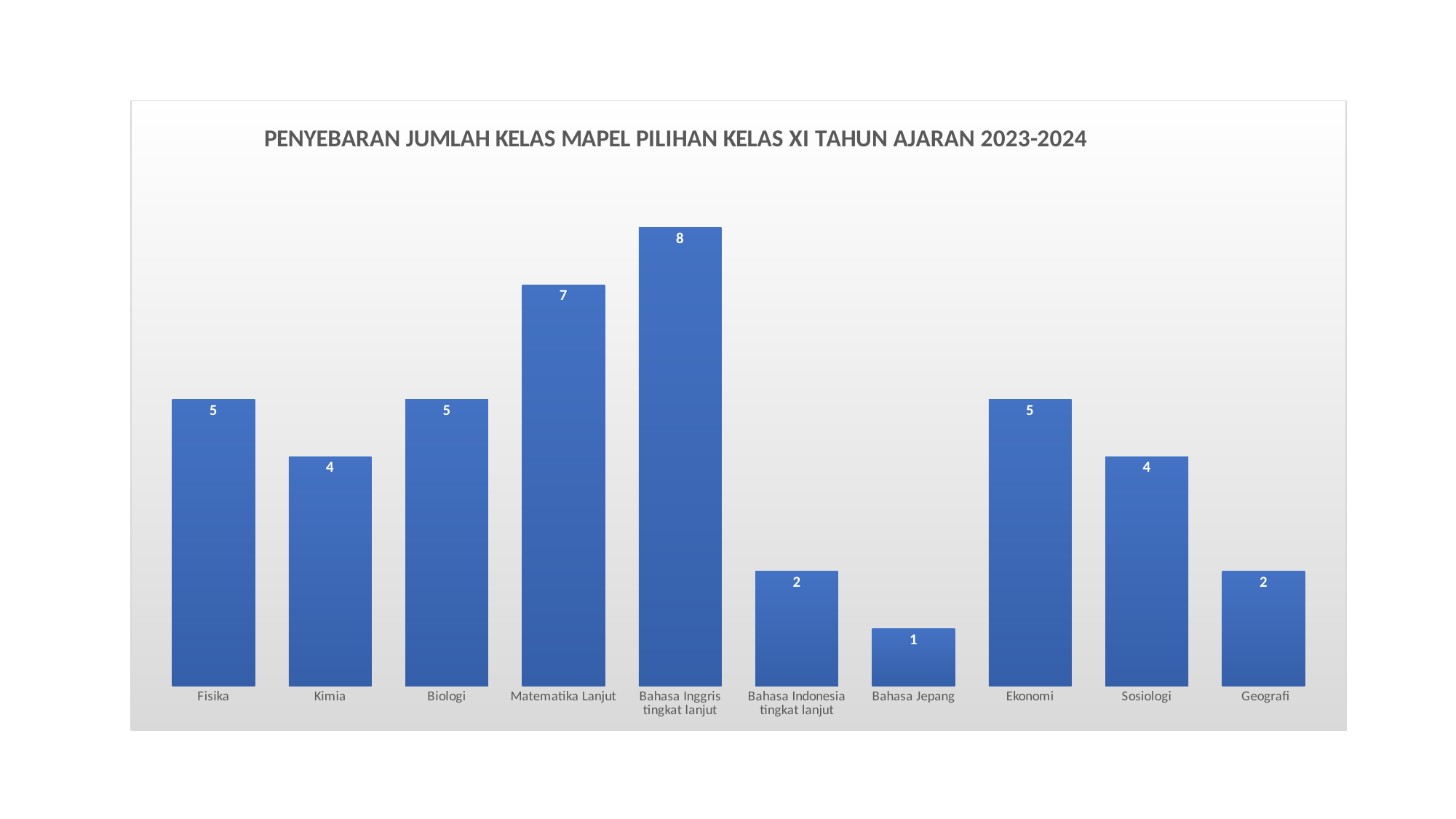
Which is larger, the value for Fisika or the value for Kimia? Fisika Which category has the highest value? Bahasa Inggris tingkat lanjut What is the value for Bahasa Jepang? 1 What is the value for Matematika Lanjut? 7 What is the difference between the values for Bahasa Inggris tingkat lanjut and Kimia? 4 What is the title of the chart? PENYEBARAN JUMLAH KELAS MAPEL PILIHAN KELAS XI TAHUN AJARAN 2023-2024 What kind of chart is shown on the slide? Bar chart What is the value for Sosiologi? 4 Which category has the lowest value? Bahasa Jepang What is the difference between the values for Ekonomi and Geografi? 3 How many categories are shown on the x axis? 10 Which is larger, the value for Bahasa Indonesia tingkat lanjut or the value for Sosiologi? Sosiologi